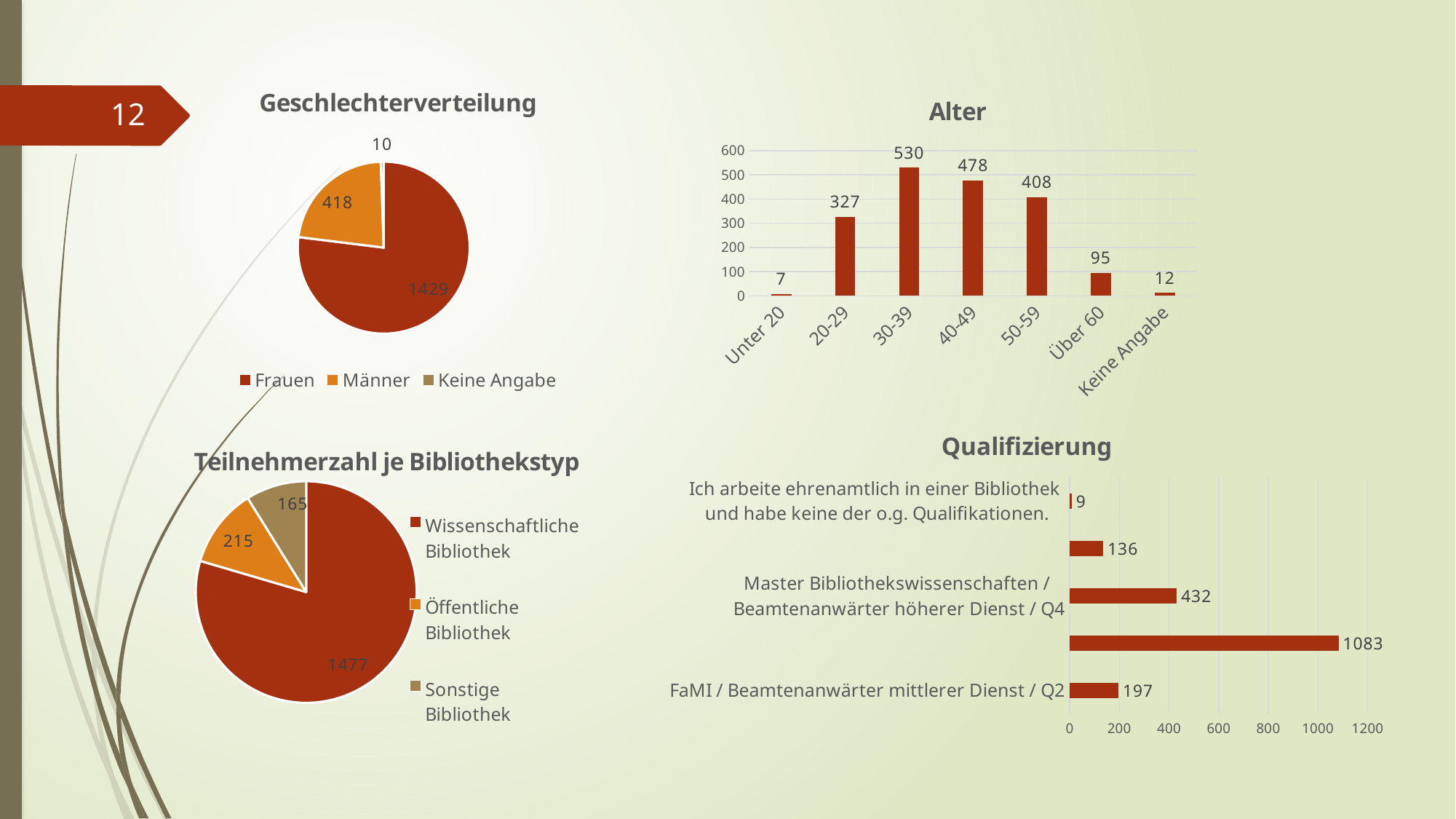
In the Alter chart, which category has the lowest value? Unter 20 In the Alter chart, what is the value for 50-59? 408 In the Qualifizierung chart, what is the value for Master Bibliothekswissenschaften / Beamtenanwärter höherer Dienst / Q4? 432 In the Geschlechterverteilung pie chart, what is the difference between the Frauen and Männer values? 1011 What kind of chart is the Alter chart? bar chart In the Alter chart, which age group has the highest value? 30-39 In the Geschlechterverteilung pie chart, what is the value for Männer? 418 How many entries does the legend of the Geschlechterverteilung chart list? 3 In the Teilnehmerzahl je Bibliothekstyp pie chart, what is the value for Öffentliche Bibliothek? 215 In the Geschlechterverteilung pie chart, what is the value for Frauen? 1429 In the Teilnehmerzahl je Bibliothekstyp pie chart, which is larger: Öffentliche Bibliothek or Sonstige Bibliothek? Öffentliche Bibliothek How many categories are shown on the x axis of the Alter chart? 7